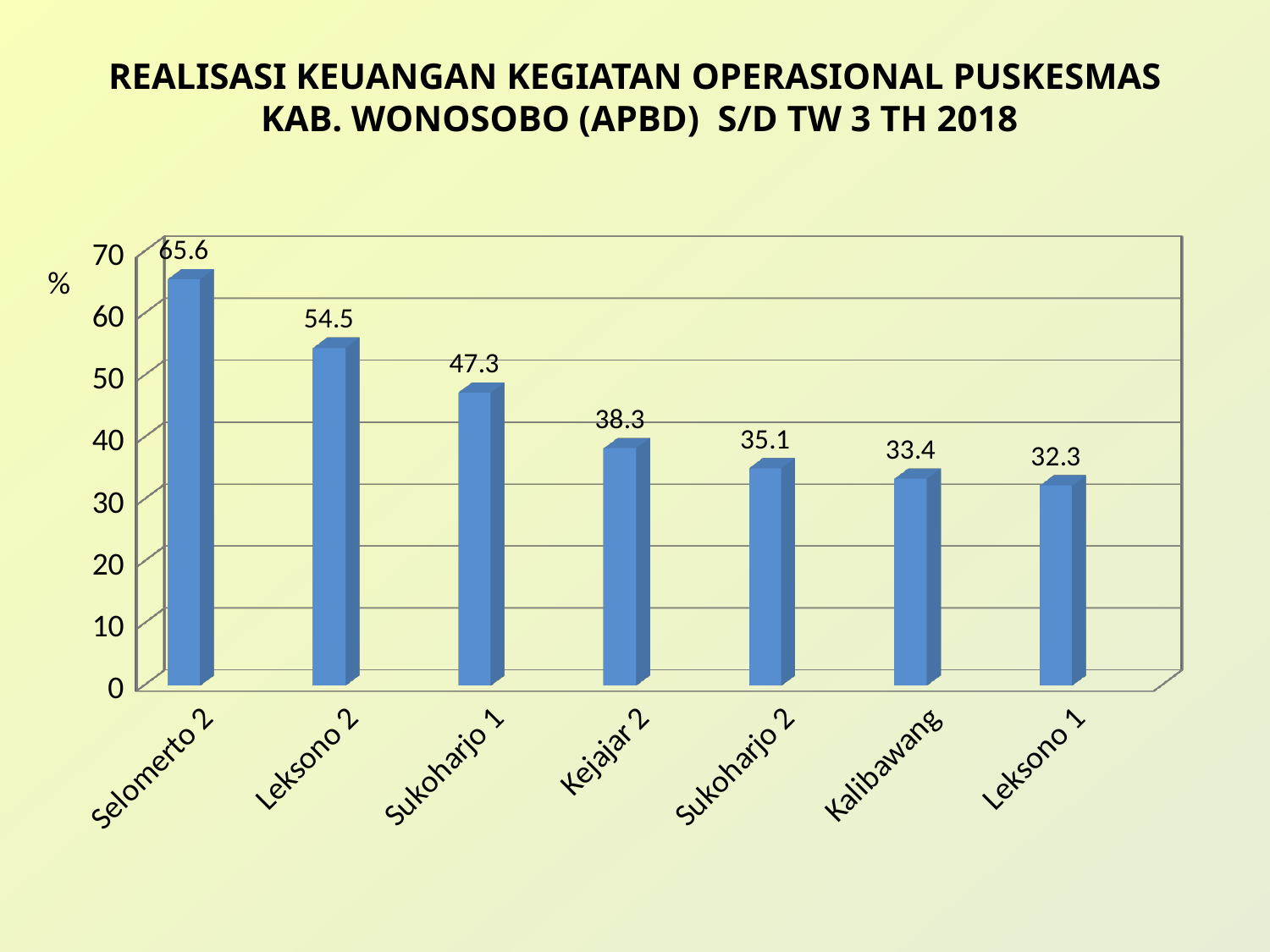
Is the value for Sukoharjo 1 greater or less than 40? greater What unit label is shown next to the vertical axis? % What is the value for Selomerto 2? 65.6 What kind of chart is shown on the slide? bar chart How many categories are shown on the x axis? 7 Which category has the lowest value? Leksono 1 Which category has the highest value? Selomerto 2 What is the difference between the values for Leksono 2 and Sukoharjo 1? 7.2 What is the value for Kalibawang? 33.4 Do the values rise or fall from left to right along the x axis? fall What is the value for Kejajar 2? 38.3 Which is larger, the value for Sukoharjo 2 or the value for Kalibawang? Sukoharjo 2